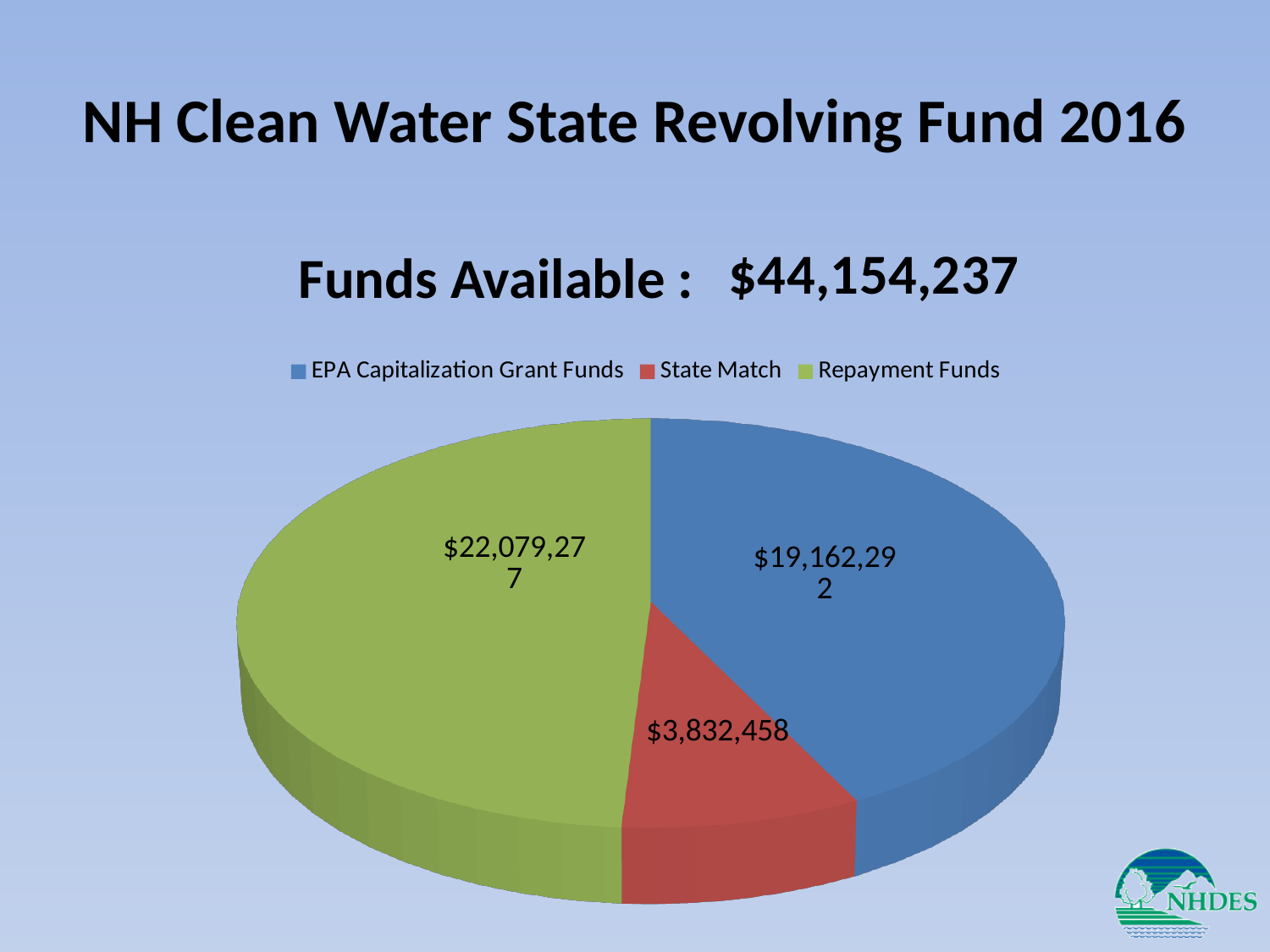
What is the value for State Match? $3,832,458 How many entries does the legend list? 3 Which is larger, EPA Capitalization Grant Funds or State Match? EPA Capitalization Grant Funds What colour is the State Match slice? red What is the value for EPA Capitalization Grant Funds? $19,162,292 Which category has the largest slice of the pie? Repayment Funds How many slices does the pie chart have? 3 What kind of chart is shown on the slide? pie chart Which category has the smallest slice of the pie? State Match What is the difference between EPA Capitalization Grant Funds and State Match? $15,329,834 What is the value for Repayment Funds? $22,079,277 What is the difference between Repayment Funds and EPA Capitalization Grant Funds? $2,916,985